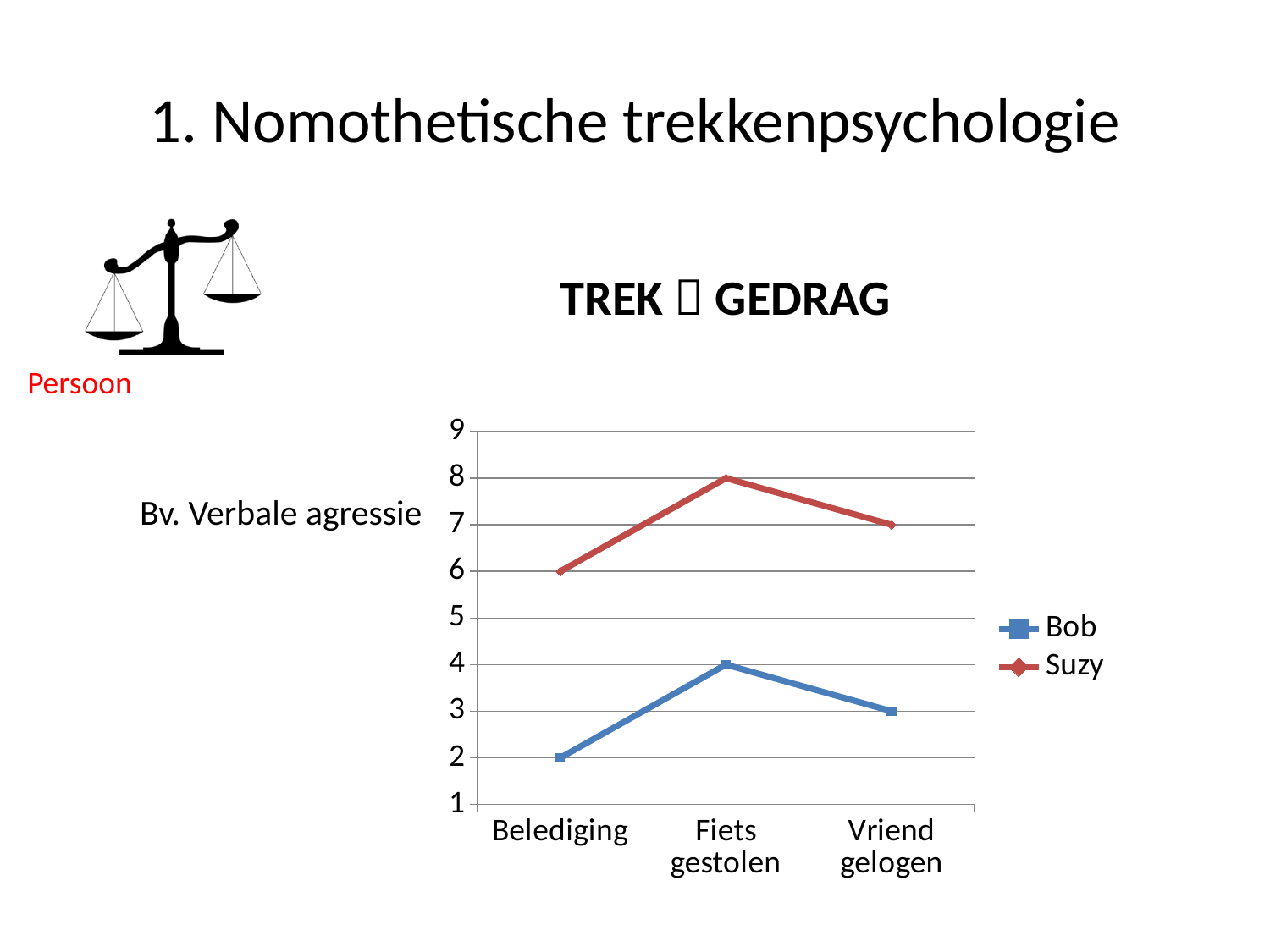
What is the value for Suzy at Belediging? 6 For which category is Suzy's value lowest? Belediging How many series does the chart legend list? 2 What is the value for Suzy at Vriend gelogen? 7 For which category is Bob's value highest? Fiets gestolen Which series has the larger value at Vriend gelogen, Bob or Suzy? Suzy What kind of chart is shown on the slide? line chart What is the difference between Suzy's and Bob's values at Fiets gestolen? 4 Does Bob's value rise or fall from Belediging to Fiets gestolen? rise How many categories are shown on the x axis of the chart? 3 Which series is drawn in red in the chart? Suzy What is the value for Bob at Fiets gestolen? 4